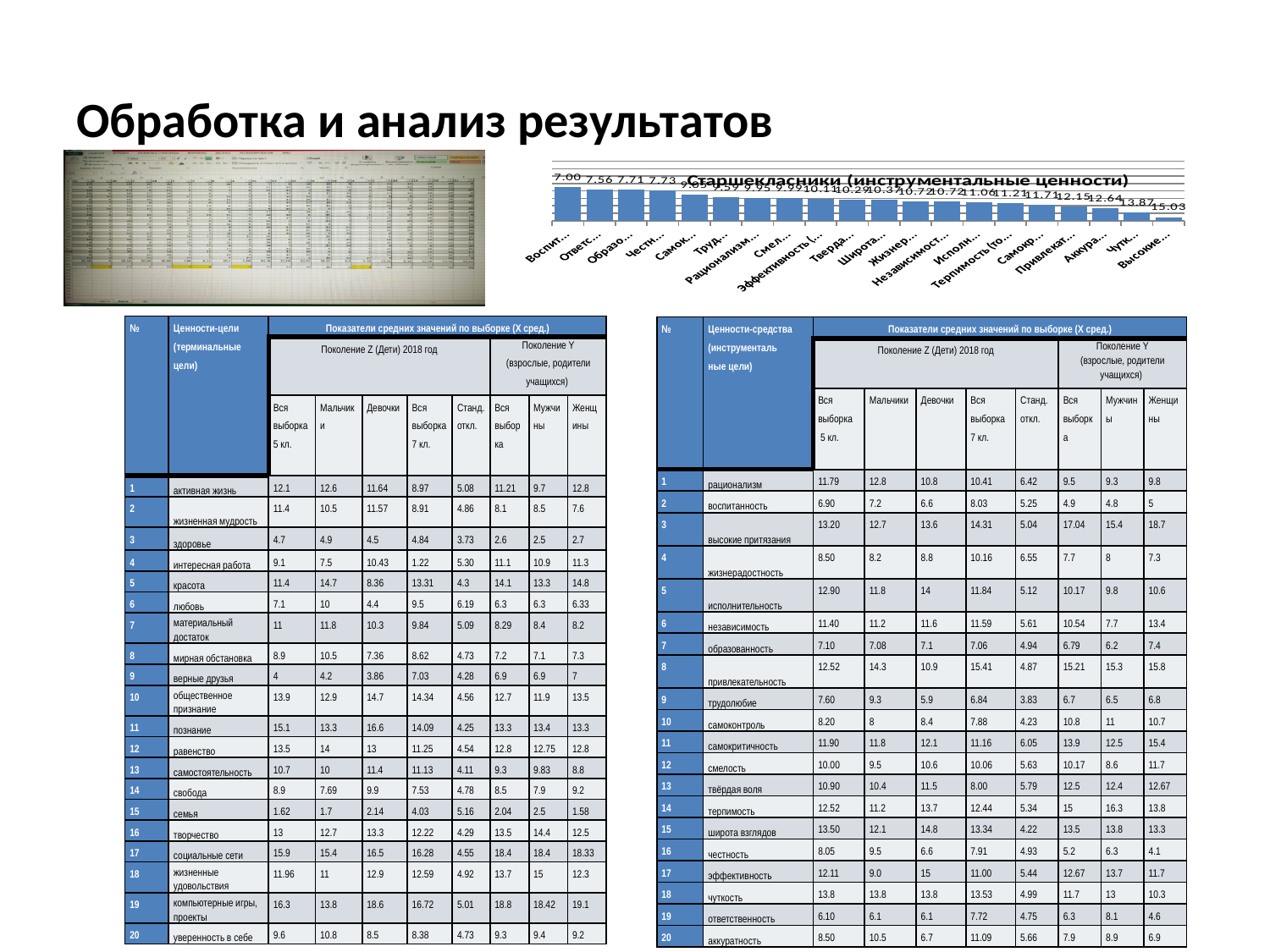
What is the title of the chart on the slide? Старшекласники (инструментальные ценности) What is the value of the second bar from the right in the chart? 13.87 What is the value of the second bar from the left in the chart? 7.56 Do the bar values rise or fall from left to right along the x axis? rise What is the lowest value shown in the chart? 7.00 What is the highest value shown in the chart? 15.03 Which is larger: the value of the leftmost bar or the value of the rightmost bar? the rightmost bar What is the value of the leftmost bar in the chart? 7.00 What is the difference between the rightmost bar (15.03) and the leftmost bar (7.00)? 8.03 What kind of chart is shown at the top right of the slide? bar chart What is the value of the rightmost bar in the chart? 15.03 How many bars does the chart contain? 20